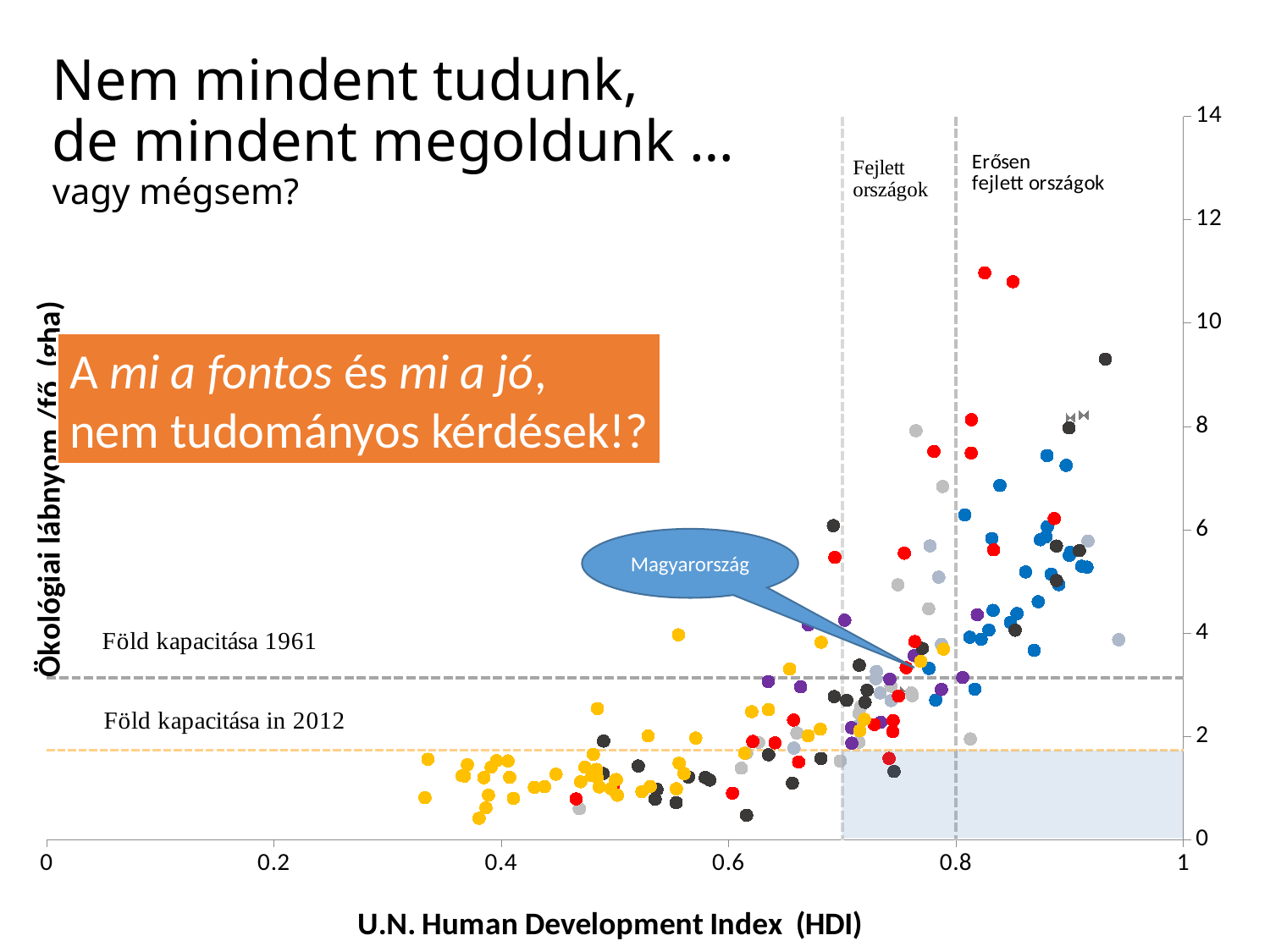
Is the ecological footprint of the highest point on the chart greater or less than 10? greater What is the title of the horizontal axis of the chart? U.N. Human Development Index (HDI) What kind of chart is shown on the slide? scatter chart Is the HDI value of the point labelled Magyarország greater or less than 0.6? greater Is the HDI value of the highest point on the chart greater or less than 0.8? greater Do the ecological footprint values generally rise or fall as HDI increases along the x axis? rise What is the title of the vertical axis of the chart? Ökológiai lábnyom /fő (gha) What is the highest value shown on the horizontal axis of the chart? 1 What is the highest value shown on the vertical axis of the chart? 14 Which horizontal dashed reference line is higher on the chart, Föld kapacitása 1961 or Föld kapacitása in 2012? Föld kapacitása 1961